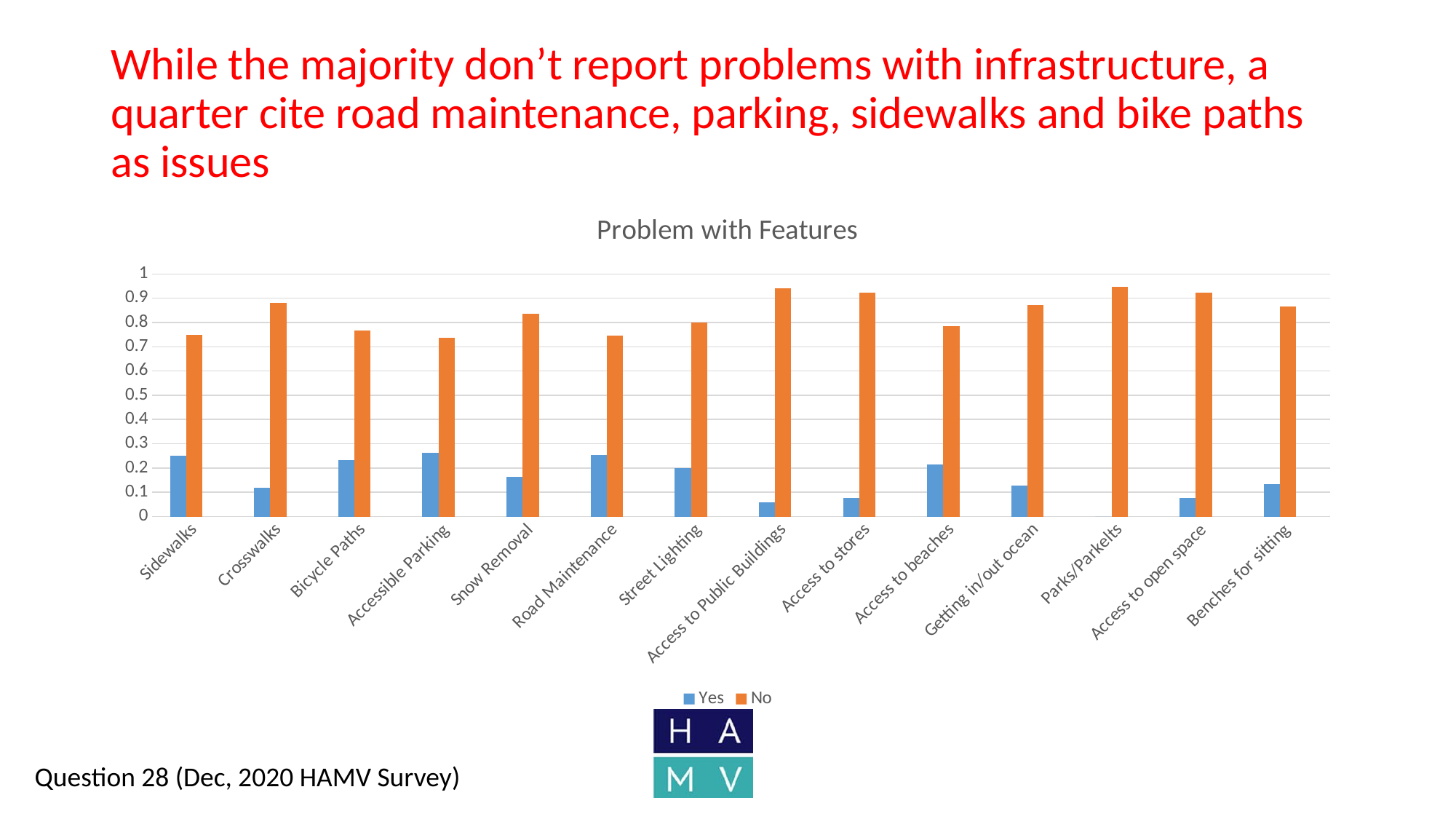
Is the 'No' value for Accessible Parking greater or less than 0.8? less Is the 'Yes' value for Crosswalks greater or less than 0.2? less Is the 'Yes' value for Access to Public Buildings greater or less than 0.1? less What is the title of the chart? Problem with Features Which is larger: the 'No' value for Snow Removal or the 'No' value for Road Maintenance? Snow Removal How many categories are shown on the x axis of the chart? 14 What kind of chart is shown on the slide? bar chart Which is larger: the 'Yes' value for Sidewalks or the 'Yes' value for Crosswalks? Sidewalks How many series does the legend list? 2